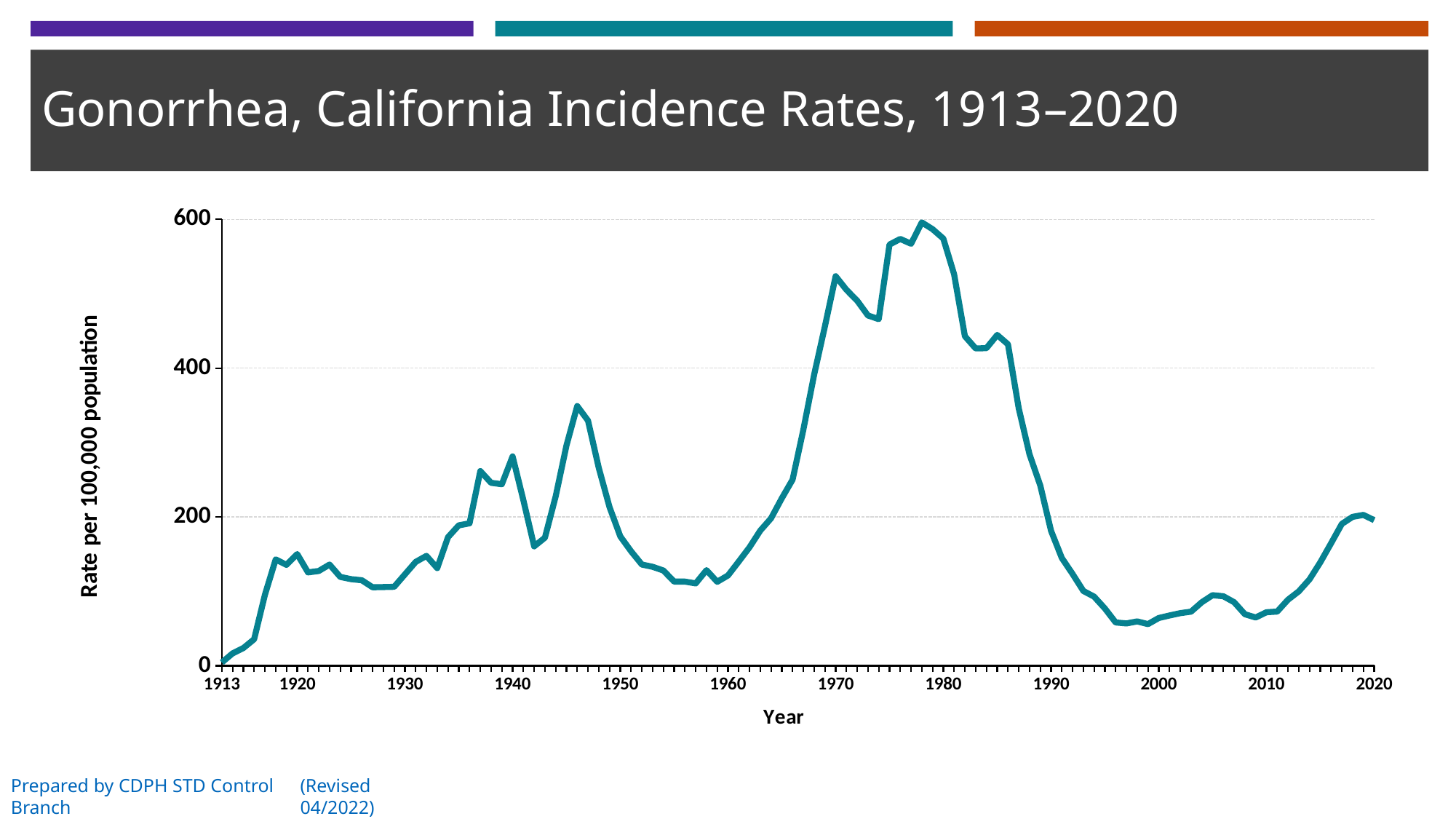
Is the value for 2020 greater or less than 400? less What is the label of the vertical axis? Rate per 100,000 population In which decade does the line reach its highest value? 1970s Is the value for 1946 greater or less than 300? greater How many lines (data series) are plotted on the chart? 1 Between 1980 and 1995, does the rate rise or fall? Fall Is the value for 2000 greater or less than 100? less What kind of chart is shown on the slide? Line chart Between 2010 and 2018, does the rate rise or fall? Rise What is the title of the chart on the slide? Gonorrhea, California Incidence Rates, 1913–2020